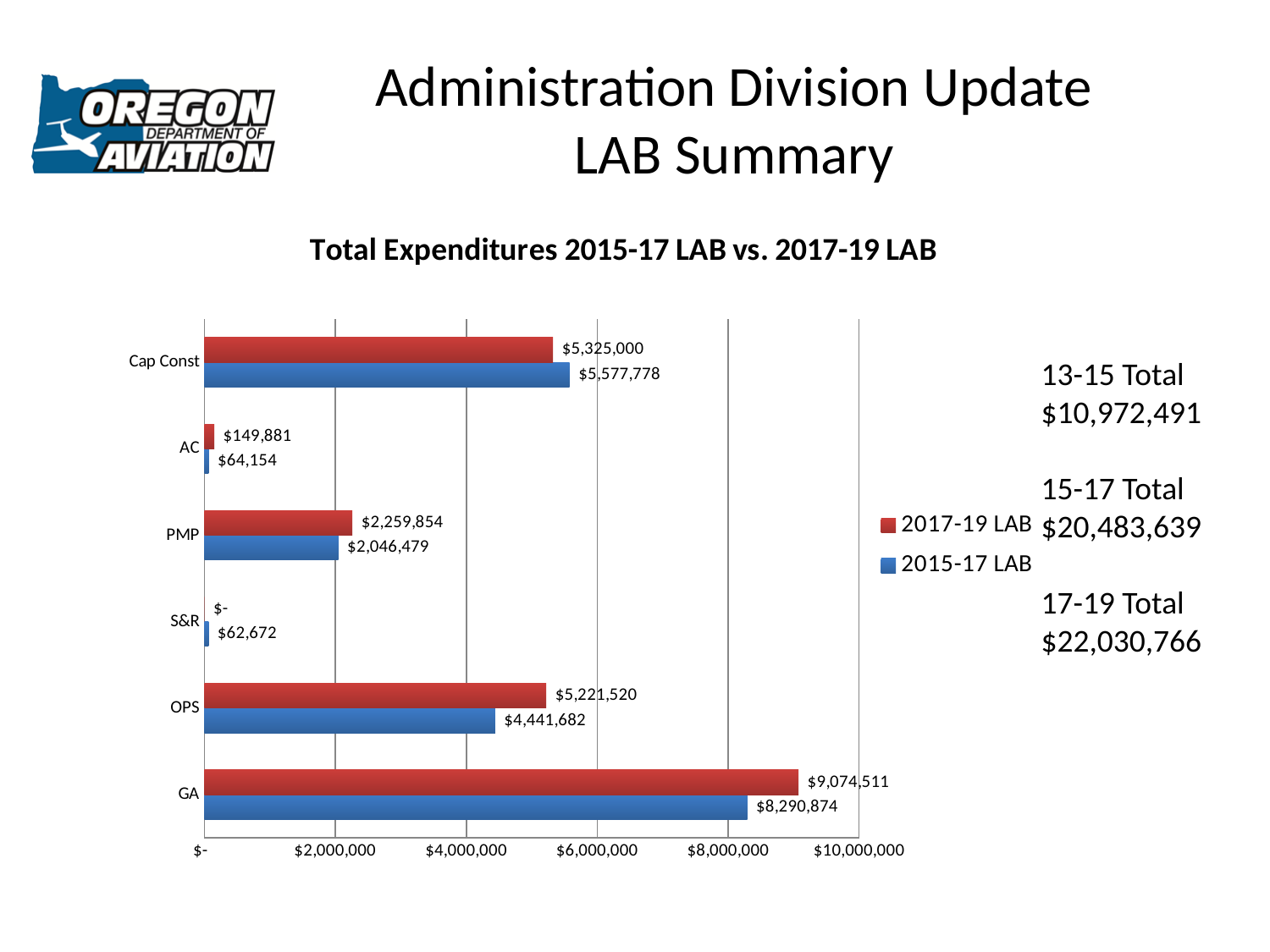
What is the 2015-17 LAB value for OPS? $4,441,682 Which category has the highest 2017-19 LAB value? GA What is the 2017-19 LAB value for GA? $9,074,511 For OPS, which is larger: the 2017-19 LAB value or the 2015-17 LAB value? 2017-19 LAB What is the 2015-17 LAB value for Cap Const? $5,577,778 What is the 2017-19 LAB value for PMP? $2,259,854 What is the difference between the 2015-17 LAB and 2017-19 LAB values for Cap Const? $252,778 Which category has the lowest 2015-17 LAB value? S&R What is the difference between the 2017-19 LAB and 2015-17 LAB values for GA? $783,637 How many categories are shown on the chart? 6 What type of chart is shown on the slide? Bar chart Is the 2015-17 LAB value for GA greater or less than $8,000,000? greater